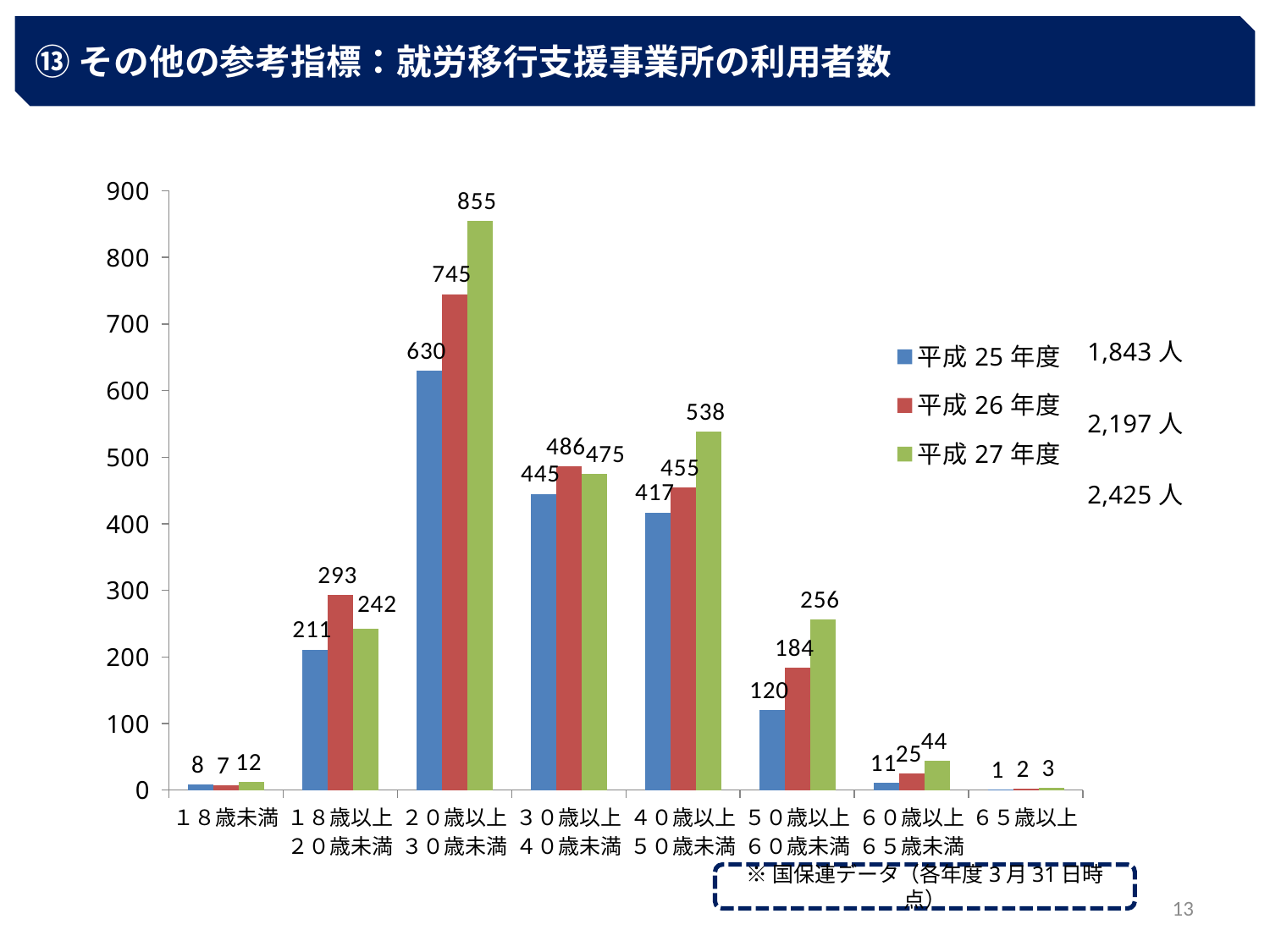
What is the difference between the 平成27年度 and 平成25年度 values in the ４０歳以上５０歳未満 category? 121 How many age categories are shown on the x axis? 8 What is the value for 平成27年度 in the ２０歳以上３０歳未満 category? 855 How many series does the legend list? 3 Is the 平成26年度 value for ２０歳以上３０歳未満 greater or less than 700? greater Which age category has the highest value for 平成27年度? ２０歳以上３０歳未満 In the ３０歳以上４０歳未満 category, which is larger: the 平成26年度 value or the 平成27年度 value? 平成26年度 What is the value for 平成25年度 in the ５０歳以上６０歳未満 category? 120 What type of chart is shown on the slide? bar chart What total number of users is shown next to the legend for 平成27年度? 2,425 人 Which age category has the lowest value for 平成25年度? ６５歳以上 What is the value for 平成26年度 in the １８歳以上２０歳未満 category? 293